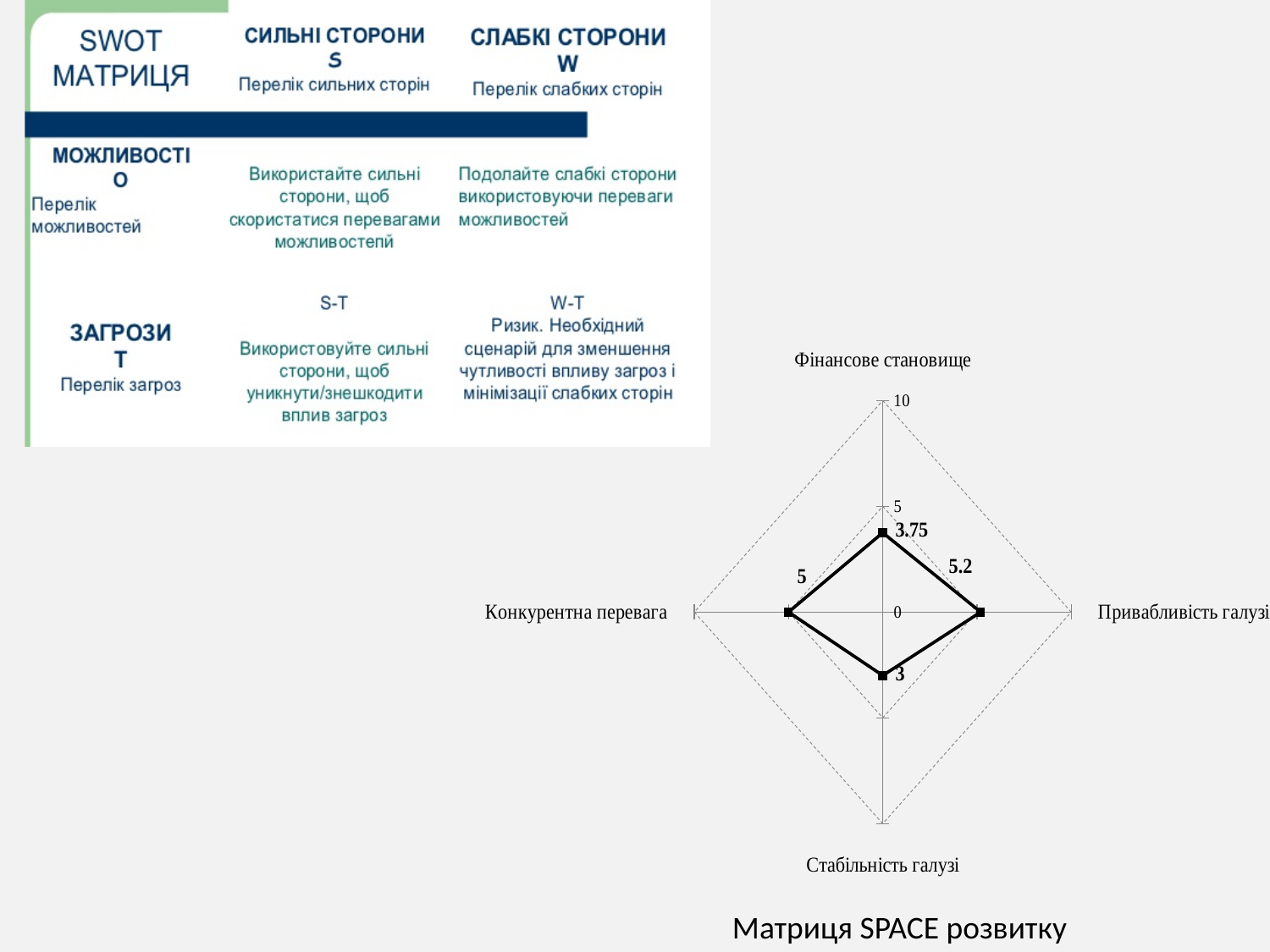
How many axes (categories) does the radar chart have? 4 Which axis of the radar chart has the highest value? Привабливість галузі What is the value for Привабливість галузі on the radar chart? 5.2 What is the difference between the values for Привабливість галузі and Стабільність галузі? 2.2 Is the value for Фінансове становище greater or less than 5? less What is the value for Стабільність галузі on the radar chart? 3 What type of chart is shown on the slide? radar chart What is the value for Конкурентна перевага on the radar chart? 5 What is the title shown below the radar chart? Матриця SPACE розвитку What is the value for Фінансове становище on the radar chart? 3.75 Which is larger on the radar chart: the value for Конкурентна перевага or the value for Фінансове становище? Конкурентна перевага Which axis of the radar chart has the lowest value? Стабільність галузі